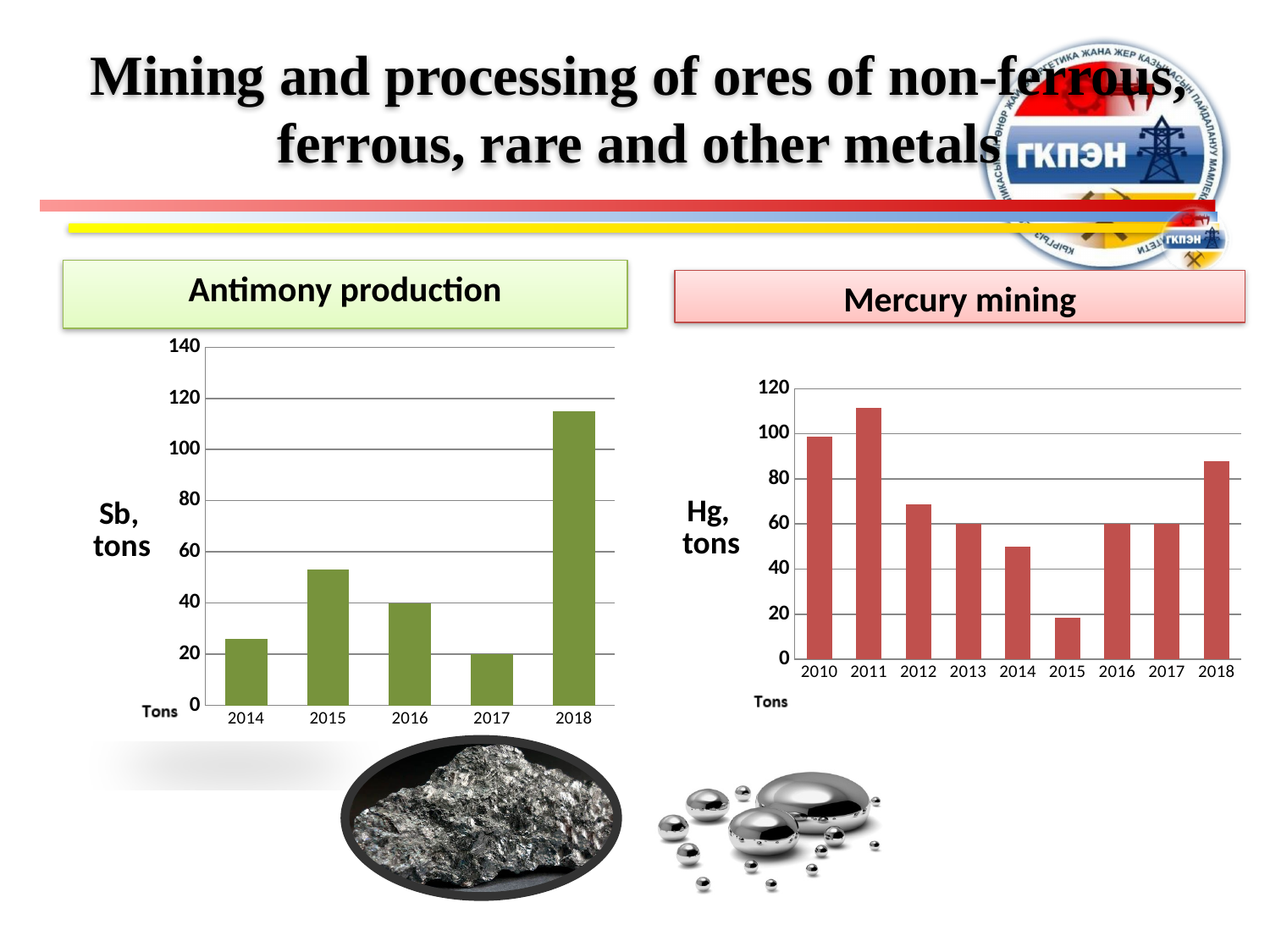
How many years are shown in the Mercury mining chart? 9 In the Antimony production chart, is the value for 2014 greater or less than 40? less In the Mercury mining chart, is the value for 2018 greater or less than 80? greater In the Antimony production chart, which year has the lowest value? 2017 In the Antimony production chart, which year has the highest value? 2018 In the Mercury mining chart, is the value for 2015 greater or less than 20? less What type of chart is the Mercury mining chart? bar chart In the Mercury mining chart, which year has the highest value? 2011 In the Mercury mining chart, which year has the lowest value? 2015 How many years are shown in the Antimony production chart? 5 In the Antimony production chart, which is larger, the value for 2015 or the value for 2016? 2015